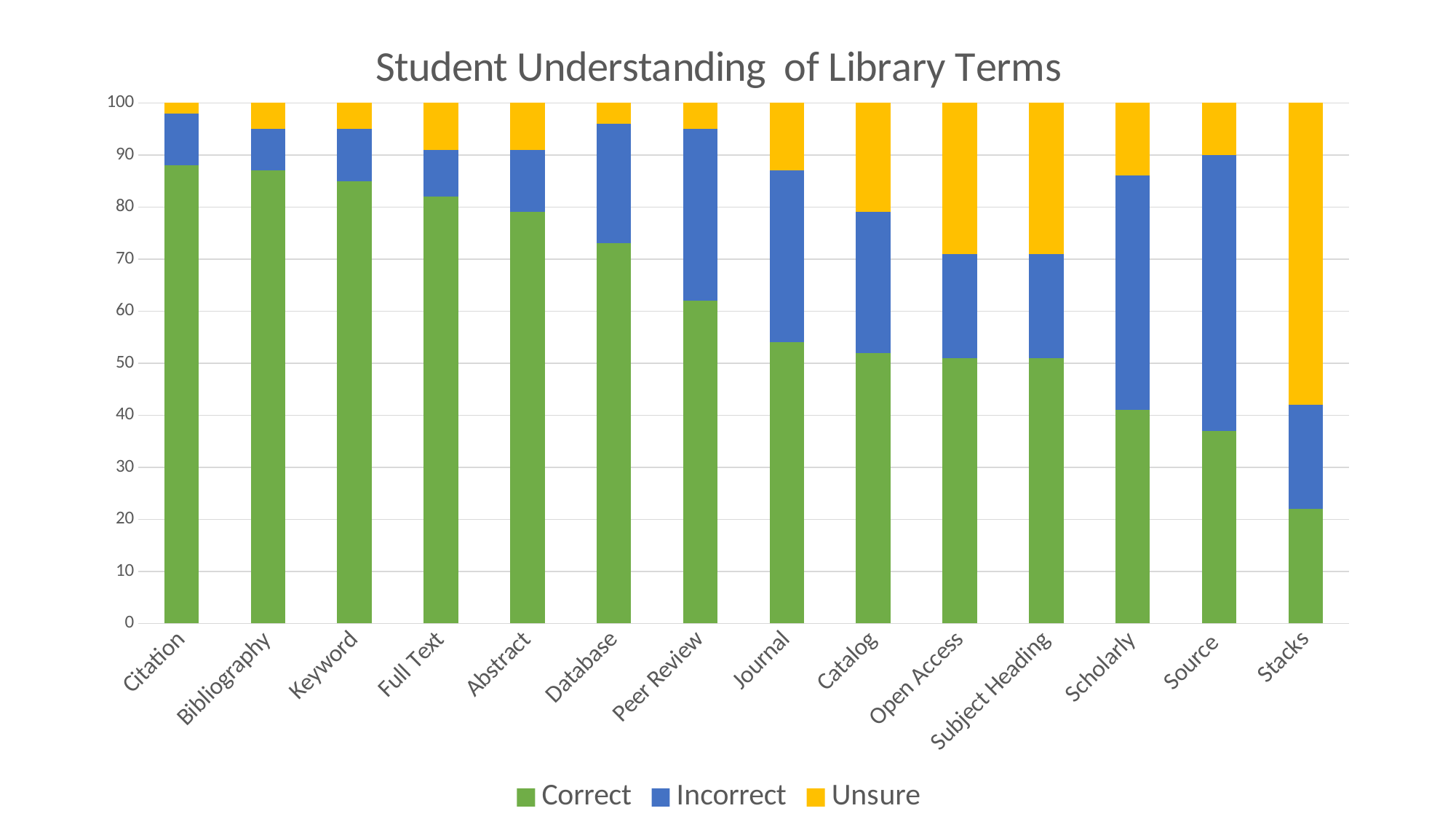
Is the Correct value for Peer Review greater or less than 70? less What kind of chart is shown on the slide? bar chart Is the Correct value for Full Text greater or less than 70? greater What is the total of the stacked bar for Citation? 100 How many series does the legend list? 3 Which library term has the lowest Correct value? Stacks What is the title of the chart? Student Understanding of Library Terms How many library terms (categories) are shown on the x axis? 14 Do the Correct values generally rise or fall from left to right along the x axis? fall Is the Correct value for Source greater or less than 40? less Which library term has the largest Unsure segment? Stacks Which has the larger Correct value, Database or Journal? Database